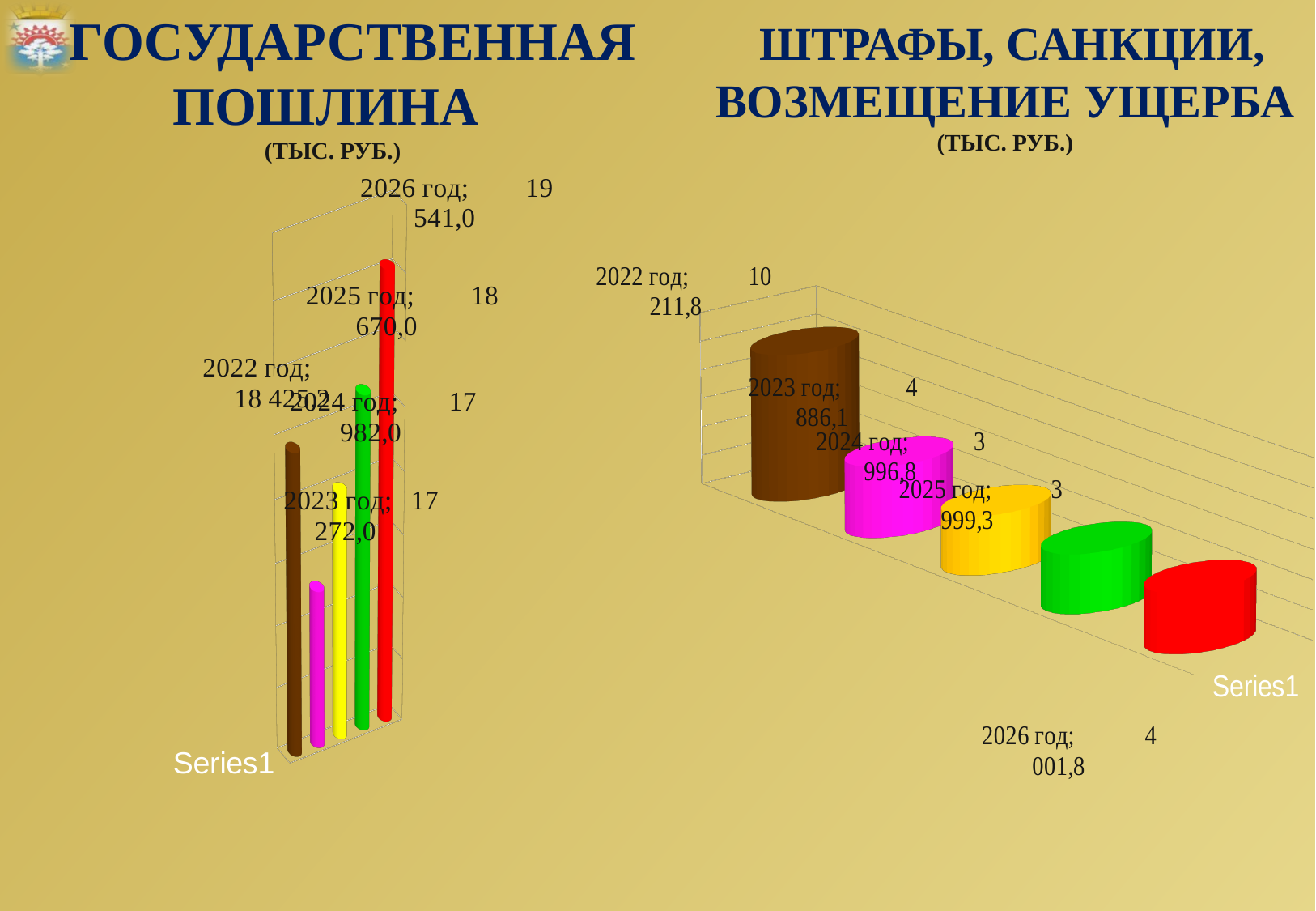
In the ГОСУДАРСТВЕННАЯ ПОШЛИНА chart, which year has the lowest value? 2023 год In the ГОСУДАРСТВЕННАЯ ПОШЛИНА chart, which year has the highest value? 2026 год In the ШТРАФЫ, САНКЦИИ, ВОЗМЕЩЕНИЕ УЩЕРБА chart, which year has the highest value? 2022 год In the ГОСУДАРСТВЕННАЯ ПОШЛИНА chart, what is the value for 2023 год? 17 272,0 In the ГОСУДАРСТВЕННАЯ ПОШЛИНА chart, do the values rise or fall from 2023 год to 2026 год? rise In the ШТРАФЫ, САНКЦИИ, ВОЗМЕЩЕНИЕ УЩЕРБА chart, how many years are plotted? 5 In the ШТРАФЫ, САНКЦИИ, ВОЗМЕЩЕНИЕ УЩЕРБА chart, what is the difference between the values for 2022 год and 2023 год? 5 325,7 In the ШТРАФЫ, САНКЦИИ, ВОЗМЕЩЕНИЕ УЩЕРБА chart, what is the value for 2022 год? 10 211,8 What kind of chart is the ГОСУДАРСТВЕННАЯ ПОШЛИНА chart? bar chart In the ГОСУДАРСТВЕННАЯ ПОШЛИНА chart, what is the value for 2026 год? 19 541,0 In the ГОСУДАРСТВЕННАЯ ПОШЛИНА chart, what is the difference between the values for 2026 год and 2022 год? 1 115,8 In the ШТРАФЫ, САНКЦИИ, ВОЗМЕЩЕНИЕ УЩЕРБА chart, what is the value for 2025 год? 3 999,3